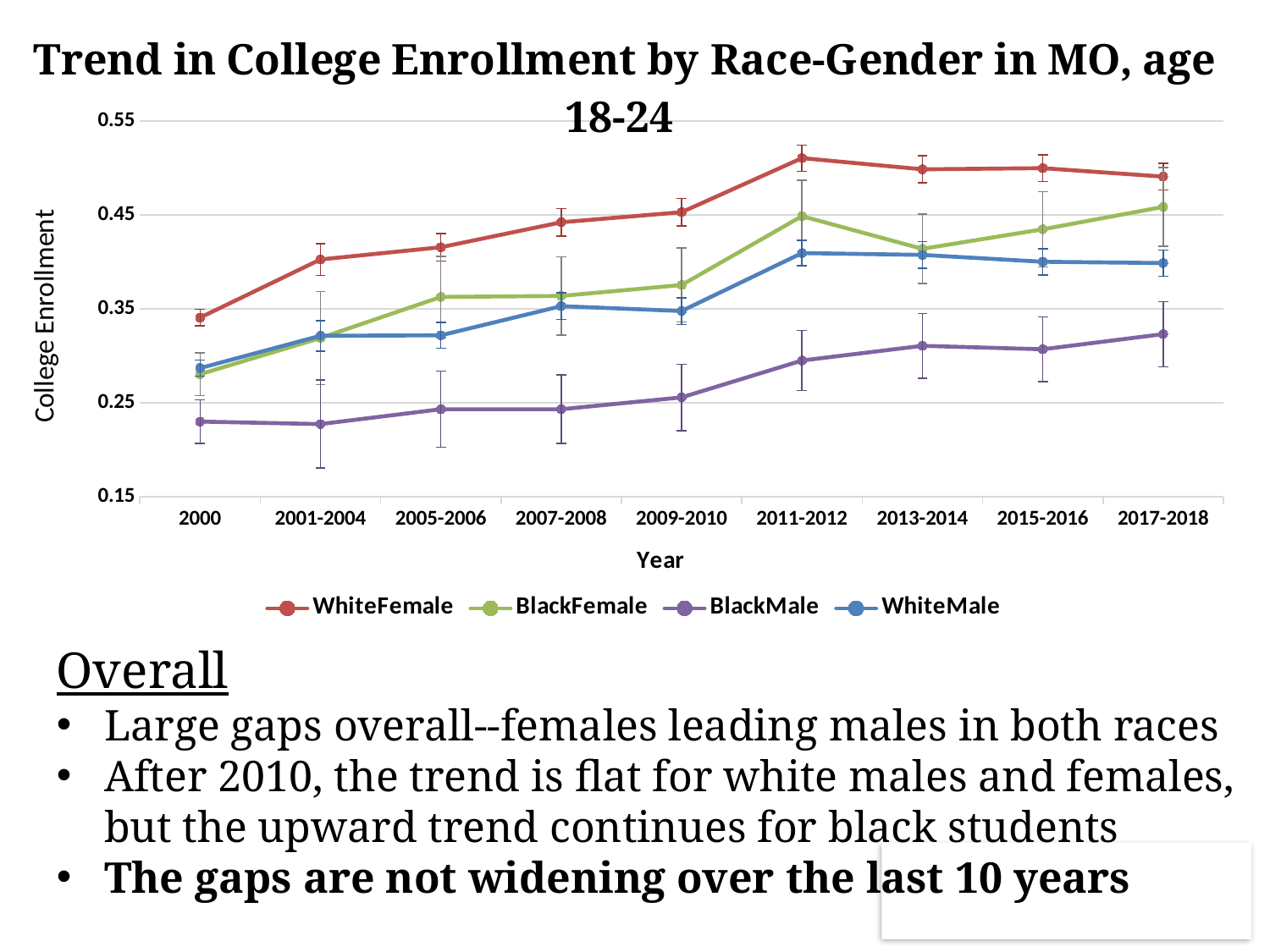
Which series has the lowest college enrollment in 2000? BlackMale Is the value for WhiteMale in 2017-2018 greater or less than 0.35? greater Which is larger in 2011-2012, the value for WhiteFemale or the value for BlackMale? WhiteFemale What is the title of the chart? Trend in College Enrollment by Race-Gender in MO, age 18-24 What kind of chart is shown on the slide? Line chart Is the value for BlackMale in 2000 greater or less than 0.25? less How many year categories are shown on the x axis? 9 How many series does the legend list? 4 What colour is the BlackMale series line? Purple Is the value for WhiteFemale in 2011-2012 greater or less than 0.45? greater Does the WhiteFemale series rise or fall from 2000 to 2011-2012? Rise Which series has the highest college enrollment in 2017-2018? WhiteFemale